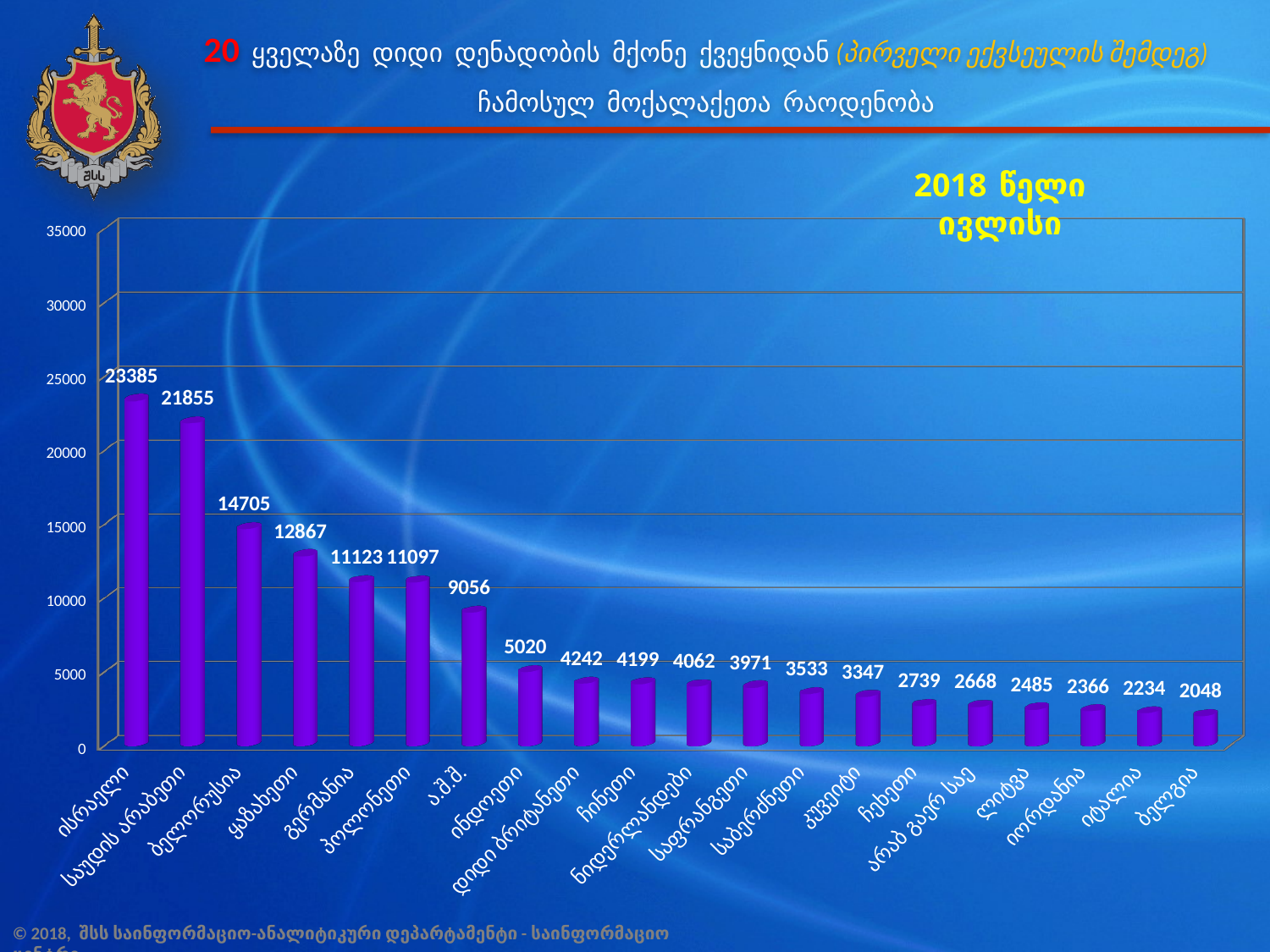
How many countries are shown in the chart? 20 What kind of chart is shown on the slide? bar chart Which country has the lowest value? ბელგია (Belgium) What is the value for ა.შ.შ. (USA)? 9056 What is the value for გერმანია (Germany)? 11123 Which is larger, the value for ბელორუსია (Belarus) or ყაზახეთი (Kazakhstan)? ბელორუსია (Belarus) What is the value for ისრაელი (Israel)? 23385 What is the value for ჩინეთი (China)? 4199 What is the difference between the values for ისრაელი (Israel) and საუდის არაბეთი (Saudi Arabia)? 1530 Which country has the highest value? ისრაელი (Israel) Do the values rise or fall from left to right along the x axis? fall Is the value for ინდოეთი (India) greater or less than 5000? greater